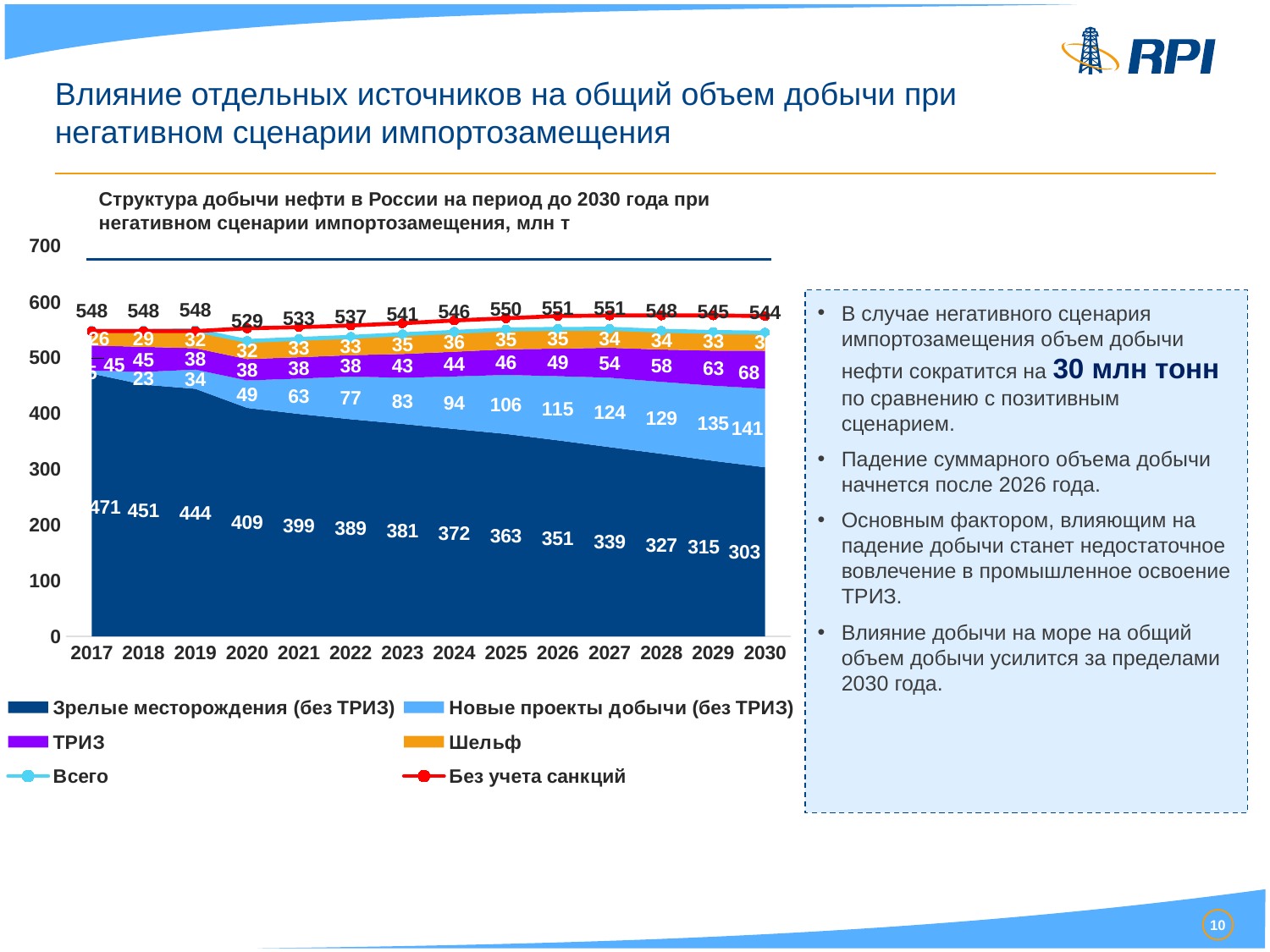
In which year is the value for Зрелые месторождения (без ТРИЗ) the highest? 2017 What is the value for Шельф in 2024? 36 In which year is the value for Зрелые месторождения (без ТРИЗ) the lowest? 2030 In 2025, which is larger: Зрелые месторождения (без ТРИЗ) or Новые проекты добычи (без ТРИЗ)? Зрелые месторождения (без ТРИЗ) What is the value for Новые проекты добычи (без ТРИЗ) in 2030? 141 What is the value for Зрелые месторождения (без ТРИЗ) in 2017? 471 By how much does the value for Зрелые месторождения (без ТРИЗ) in 2017 exceed its value in 2030? 168 What is the value for ТРИЗ in 2027? 54 How many years are shown on the x axis? 14 What is the value for Зрелые месторождения (без ТРИЗ) in 2030? 303 Do the values for Новые проекты добычи (без ТРИЗ) rise or fall from 2018 to 2030? rise How many series does the legend list? 6